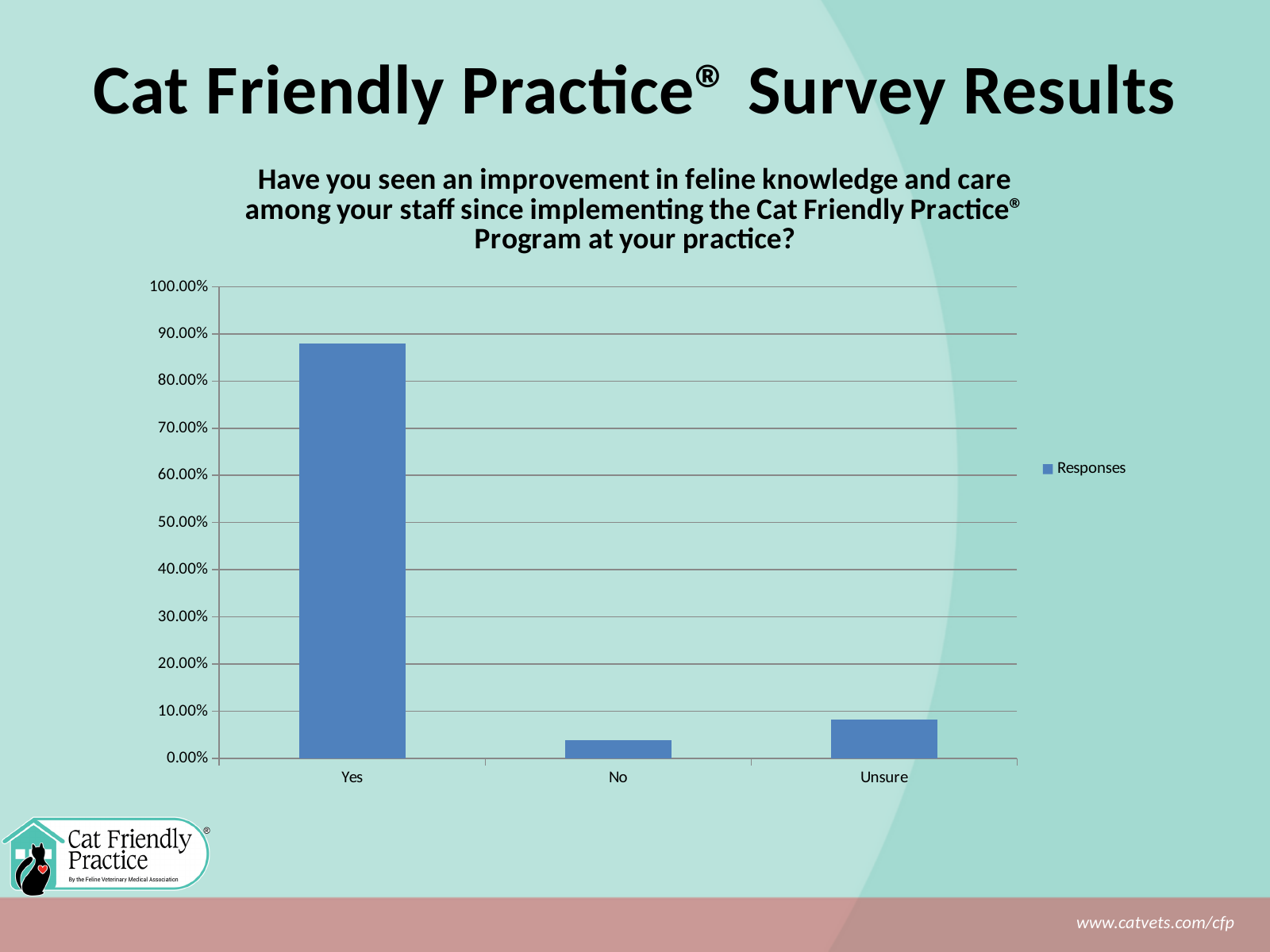
How many series does the legend list? 1 Which response category has the highest value? Yes What is the name of the series shown in the legend? Responses What kind of chart is shown on the slide? bar chart Is the value for Yes greater or less than 80.00%? greater What is the highest value shown on the y axis? 100.00% Which is larger, the value for No or the value for Unsure? Unsure Which response category has the lowest value? No Is the value for Yes greater or less than 50.00%? greater How many response categories are shown on the x axis? 3 Is the value for No greater or less than 10.00%? less